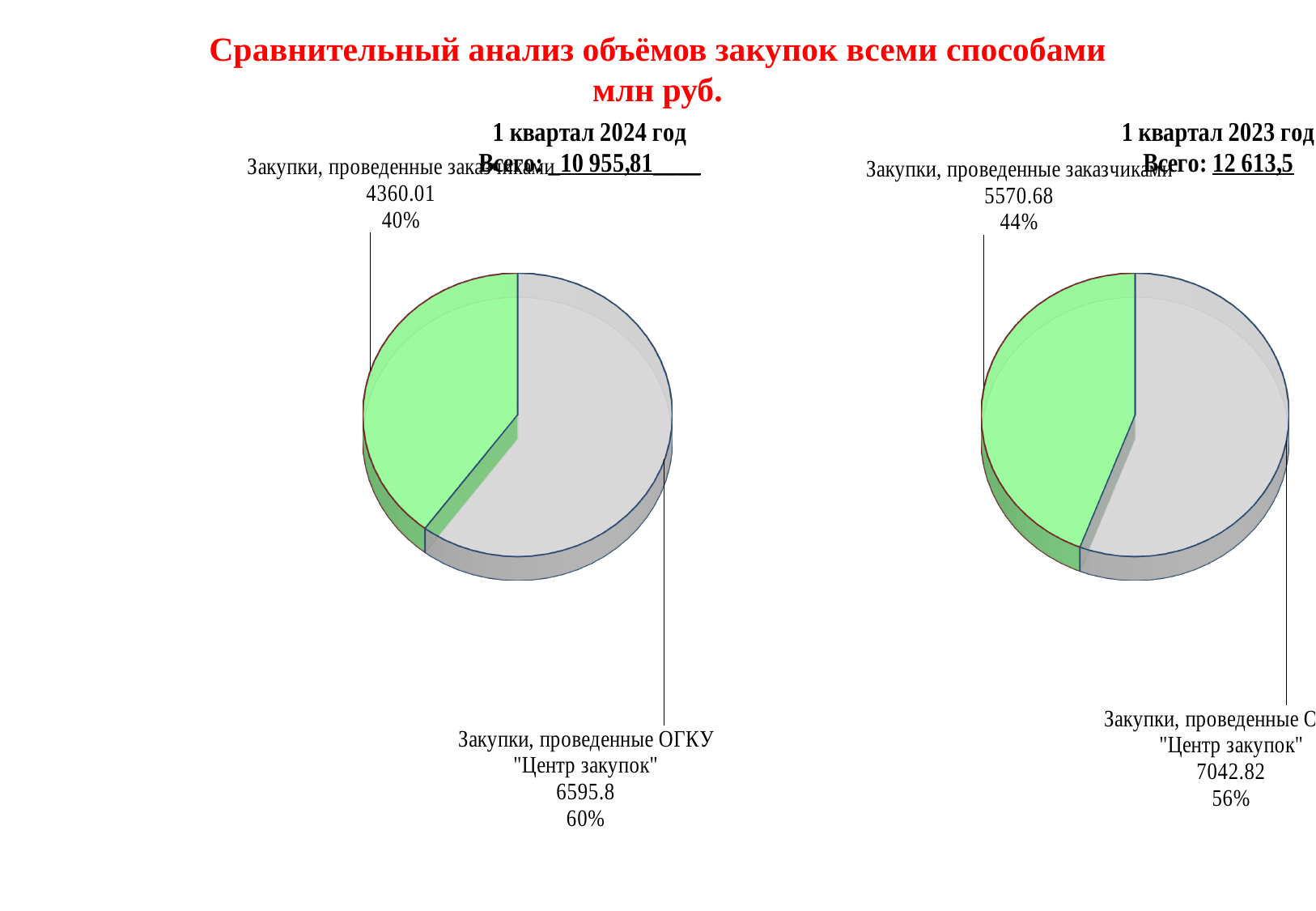
In the "1 квартал 2024 год" pie chart, what is the value for "Закупки, проведенные ОГКУ "Центр закупок""? 6595.8 In the "1 квартал 2024 год" pie chart, what share of the pie is "Закупки, проведенные заказчиками"? 40% In the "1 квартал 2024 год" pie chart, what is the difference between the "Центр закупок" value and the "заказчиками" value? 2235.79 Which is larger: "Закупки, проведенные заказчиками" in the 2024 chart or in the 2023 chart? 2023 chart In the "1 квартал 2023 год" pie chart, what is the value for "Закупки, проведенные заказчиками"? 5570.68 In the "1 квартал 2023 год" pie chart, what is the value for the "Центр закупок" slice? 7042.82 In the "1 квартал 2024 год" pie chart, which slice is the largest? Закупки, проведенные ОГКУ "Центр закупок" What type of chart is used on this slide? Pie chart In the "1 квартал 2023 год" pie chart, which slice is the smallest? Закупки, проведенные заказчиками How many slices does the "1 квартал 2023 год" pie chart have? 2 In the "1 квартал 2023 год" pie chart, what share of the pie is the "Центр закупок" slice? 56% In the "1 квартал 2024 год" pie chart, what is the value for "Закупки, проведенные заказчиками"? 4360.01